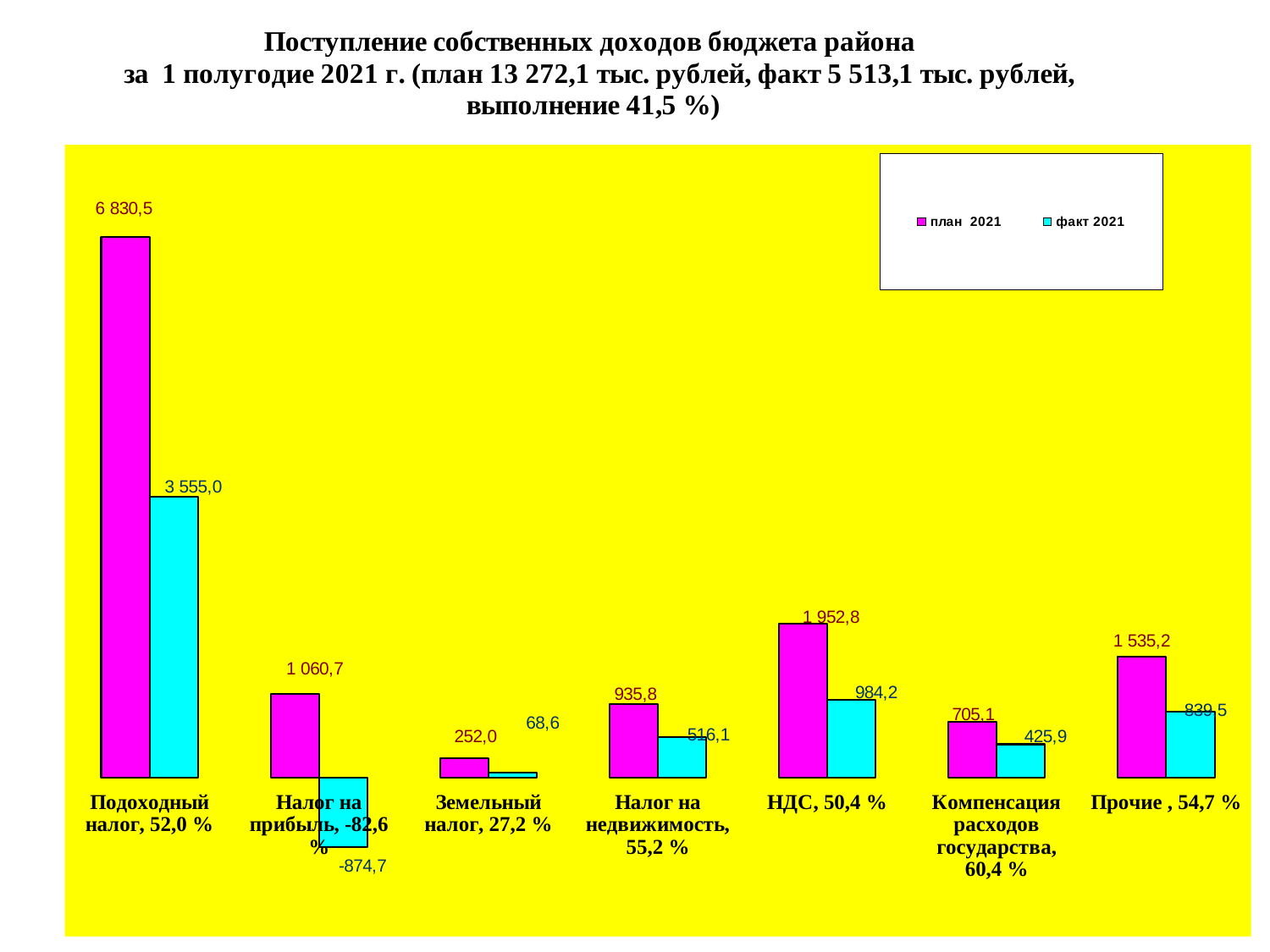
Which category has the lowest факт 2021 value? Налог на прибыль What is the факт 2021 value for НДС? 984,2 How many categories are shown on the x axis? 7 What is the факт 2021 value for Налог на прибыль? -874,7 How many series does the legend list? 2 What is the план 2021 value for Подоходный налог? 6 830,5 What is the difference between the план 2021 and факт 2021 values for Подоходный налог? 3 275,5 Which category has the highest план 2021 value? Подоходный налог What kind of chart is shown on the slide? Bar chart Which is larger: the план 2021 value for НДС or the план 2021 value for Прочие? НДС What is the план 2021 value for Компенсация расходов государства? 705,1 Which category has the lowest план 2021 value? Земельный налог